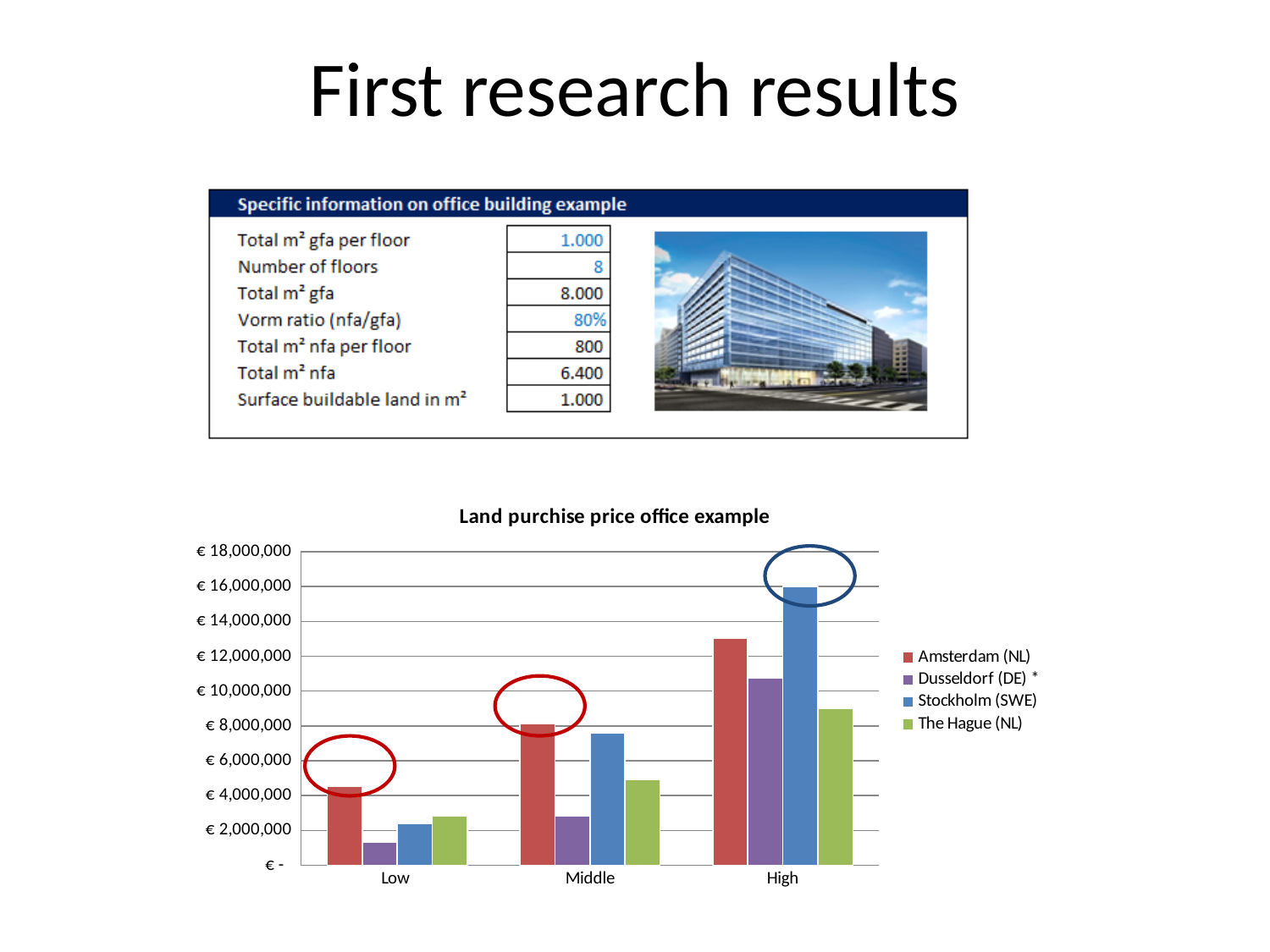
How many series does the chart legend list? 4 Which city has the highest land purchase price in the Middle category? Amsterdam (NL) How many categories are shown on the x axis of the chart? 3 Is the value for Stockholm (SWE) in the High category greater or less than € 14,000,000? greater What is the title of the chart? Land purchise price office example In the Middle category, which is larger: the value for Stockholm (SWE) or The Hague (NL)? Stockholm (SWE) Which city has the highest land purchase price in the High category? Stockholm (SWE) Which series is shown in green in the chart? The Hague (NL) Do the values for Amsterdam (NL) rise or fall from Low to High? rise Is the value for Amsterdam (NL) in the Low category greater or less than € 6,000,000? less What kind of chart is shown on the slide? bar chart Which city has the lowest land purchase price in the Low category? Dusseldorf (DE) *